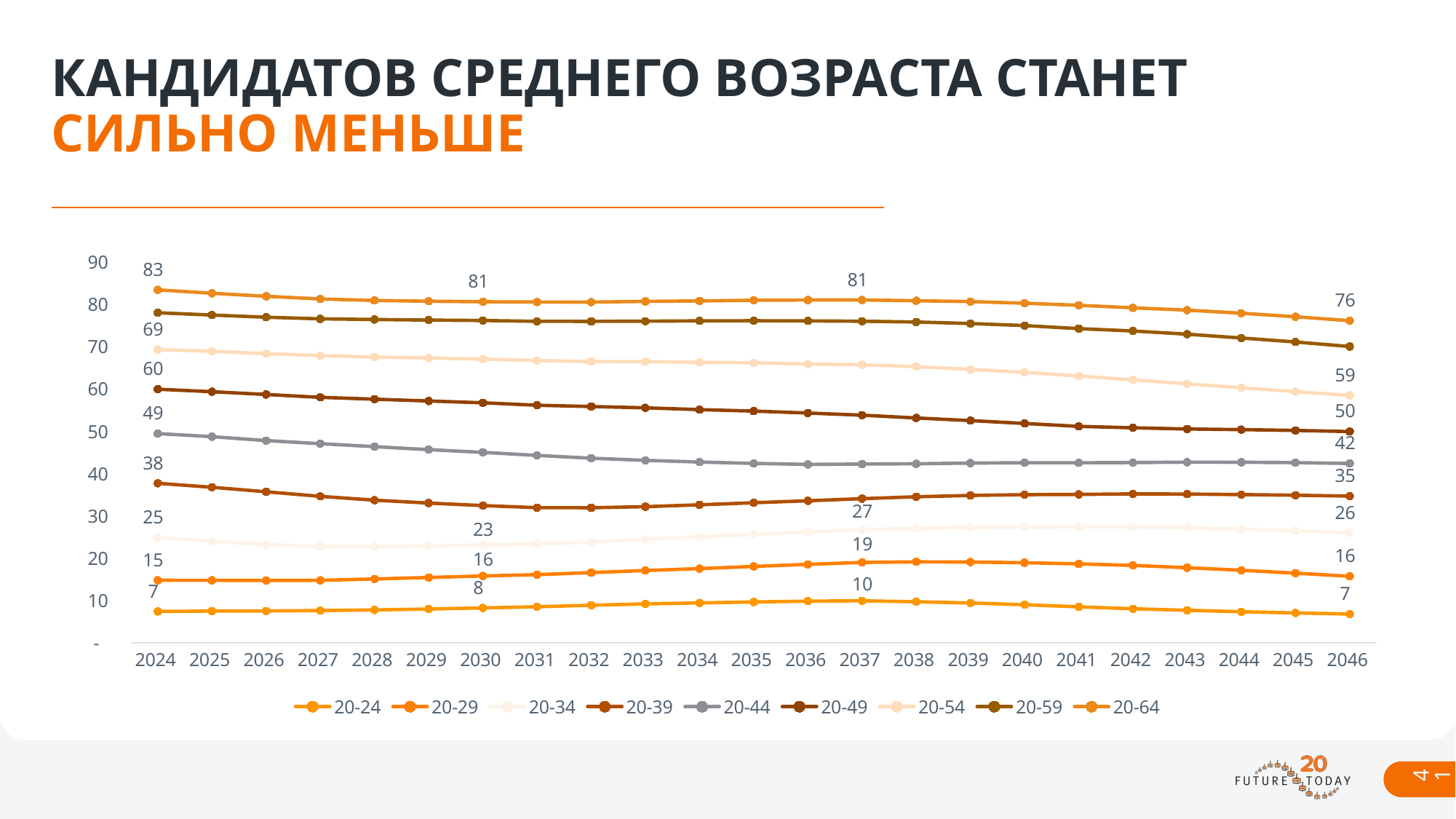
Does the 20-44 series rise or fall from 2024 to 2046? fall How many series does the legend list? 9 What is the value for the 20-24 series in 2037? 10 By how much does the 20-64 series fall from 2024 to 2046? 7 What is the value for the 20-44 series in 2024? 49 What is the value for the 20-64 series in 2046? 76 What kind of chart is shown on the slide? line chart How many years are shown along the x axis? 23 Which series has the highest values across the chart? 20-64 What is the value for the 20-49 series in 2046? 50 What is the value for the 20-64 series in 2024? 83 Which series has the lowest values across the chart? 20-24